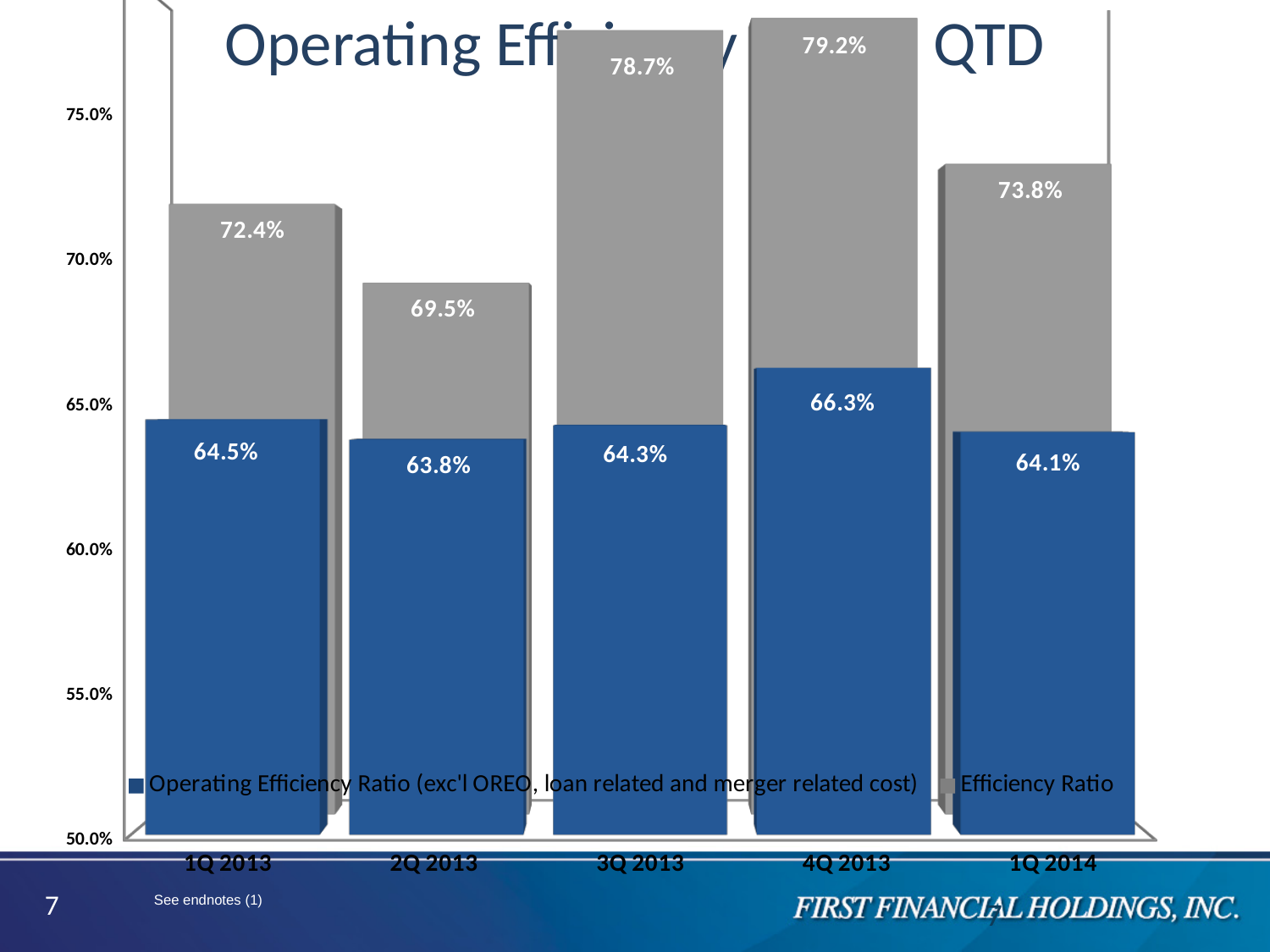
Which quarter has the lowest Operating Efficiency Ratio (exc'l OREO, loan related and merger related cost)? 2Q 2013 What is the Efficiency Ratio for 3Q 2013? 78.7% How many series does the legend list? 2 What is the Efficiency Ratio for 1Q 2014? 73.8% Which is larger: the Efficiency Ratio for 1Q 2013 or for 2Q 2013? 1Q 2013 Is the Efficiency Ratio for 2Q 2013 greater or less than 70.0%? less What is the Operating Efficiency Ratio (exc'l OREO, loan related and merger related cost) for 4Q 2013? 66.3% How many quarters are shown on the x axis? 5 What kind of chart is shown on the slide? Bar chart Which quarter has the highest Efficiency Ratio? 4Q 2013 What is the difference between the Efficiency Ratio and the Operating Efficiency Ratio (exc'l OREO, loan related and merger related cost) in 4Q 2013? 12.9% Which colour represents the Efficiency Ratio series? Gray